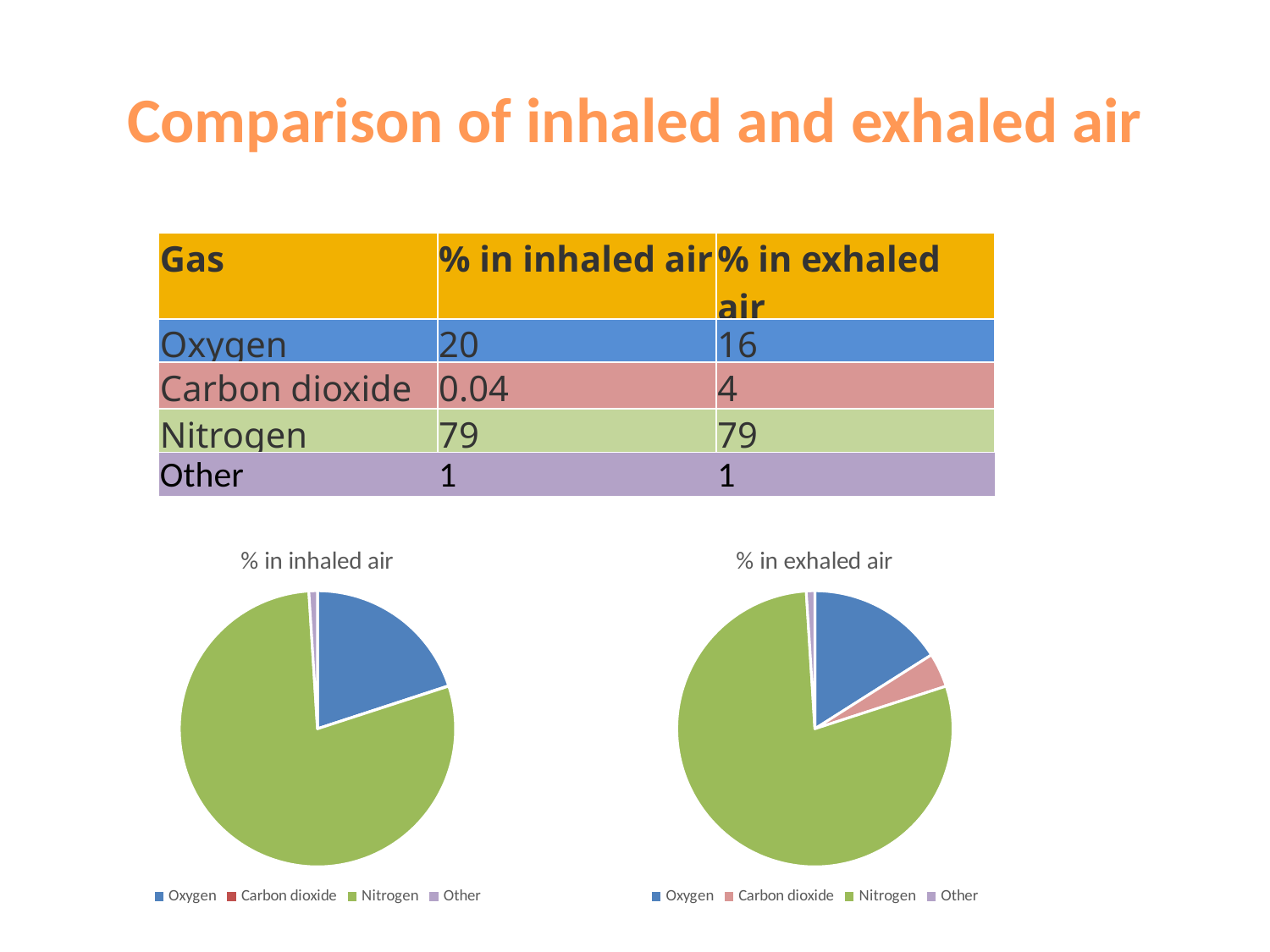
In the "% in exhaled air" pie chart, is the Oxygen slice larger or smaller than the Carbon dioxide slice? larger In the "% in exhaled air" pie chart, which gas has the largest slice? Nitrogen In the "% in inhaled air" pie chart, which gas has the largest slice? Nitrogen What is the difference between the Oxygen values in the inhaled air and exhaled air charts? 4 How many slices does the "% in exhaled air" pie chart have according to its legend? 4 What kind of chart is the "% in inhaled air" chart? pie chart What colour represents Nitrogen in the "% in inhaled air" pie chart? green What is the value for Oxygen in the "% in inhaled air" chart? 20 In the "% in exhaled air" pie chart, which gas has the smallest slice? Other In the "% in inhaled air" pie chart, which gas has the smallest slice? Carbon dioxide What is the value for Carbon dioxide in the "% in exhaled air" chart? 4 What is the title of the pie chart on the right of the slide? % in exhaled air